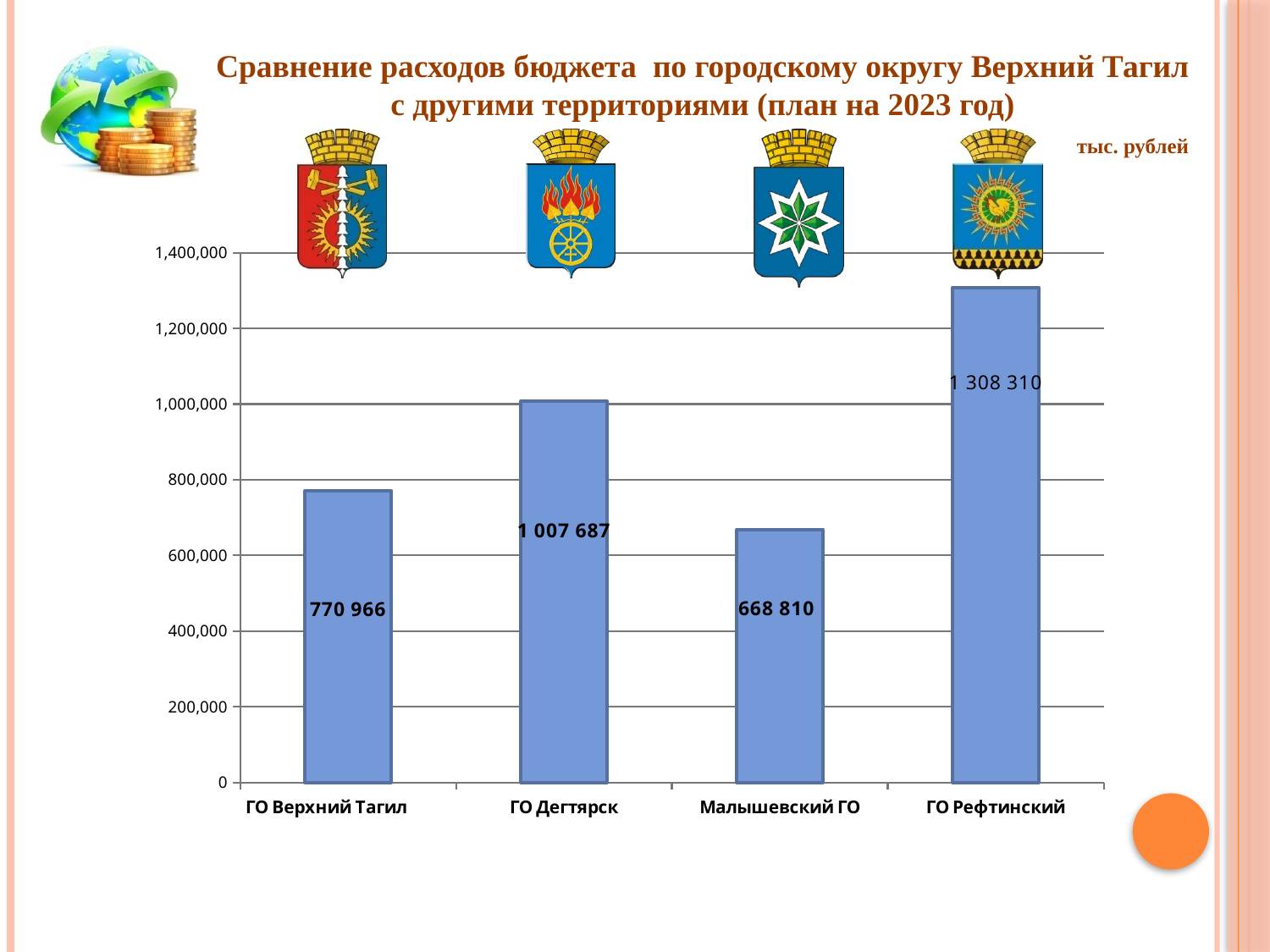
What is the planned 2023 budget expenditure for ГО Верхний Тагил? 770 966 What type of chart is shown on the slide? bar chart What is the value shown for Малышевский ГО? 668 810 What is the value shown for ГО Рефтинский? 1 308 310 Which is larger, the value for ГО Дегтярск or the value for ГО Верхний Тагил? ГО Дегтярск Is the value for ГО Дегтярск greater or less than 1,000,000? greater What is the difference between the values for ГО Верхний Тагил and Малышевский ГО? 102 156 What is the difference between the values for ГО Рефтинский and ГО Верхний Тагил? 537 344 What is the value shown for ГО Дегтярск? 1 007 687 Which territory has the highest planned budget expenditure? ГО Рефтинский How many territories are compared in the chart? 4 Which territory has the lowest planned budget expenditure? Малышевский ГО